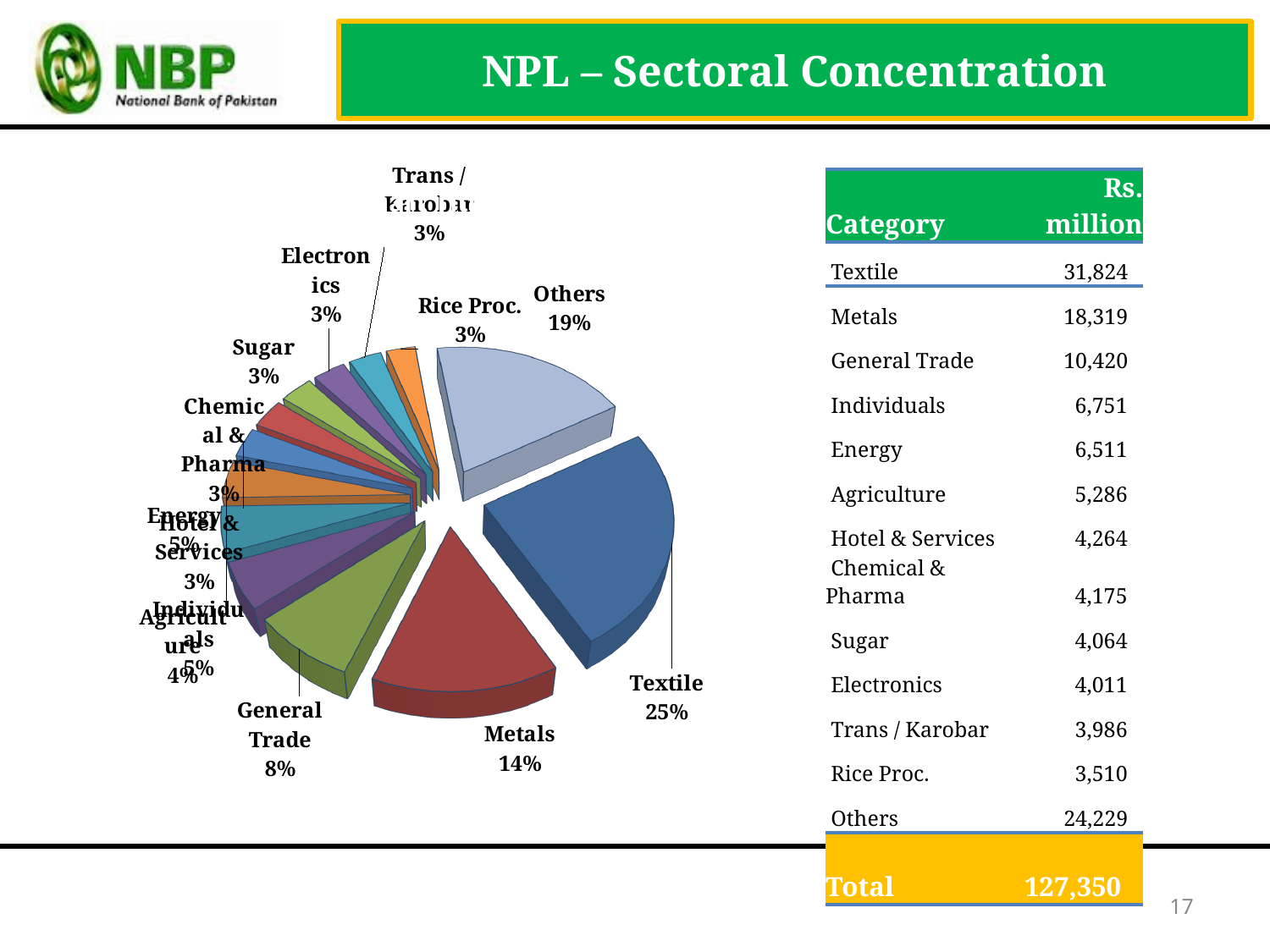
What is the title of the slide containing the pie chart? NPL – Sectoral Concentration Which category has the largest slice of the pie chart? Textile What percentage is shown for Others in the pie chart? 19% What kind of chart is shown on the slide? pie chart What percentage is shown for Rice Proc. in the pie chart? 3% How many slices does the pie chart have? 13 What percentage is shown for General Trade in the pie chart? 8% Which slice is larger in the pie chart, Others or Metals? Others What percentage is shown for Metals in the pie chart? 14% What share of the pie does Textile represent? 25% What percentage is shown for Sugar in the pie chart? 3% What is the difference in percentage points between the Textile slice and the Metals slice? 11